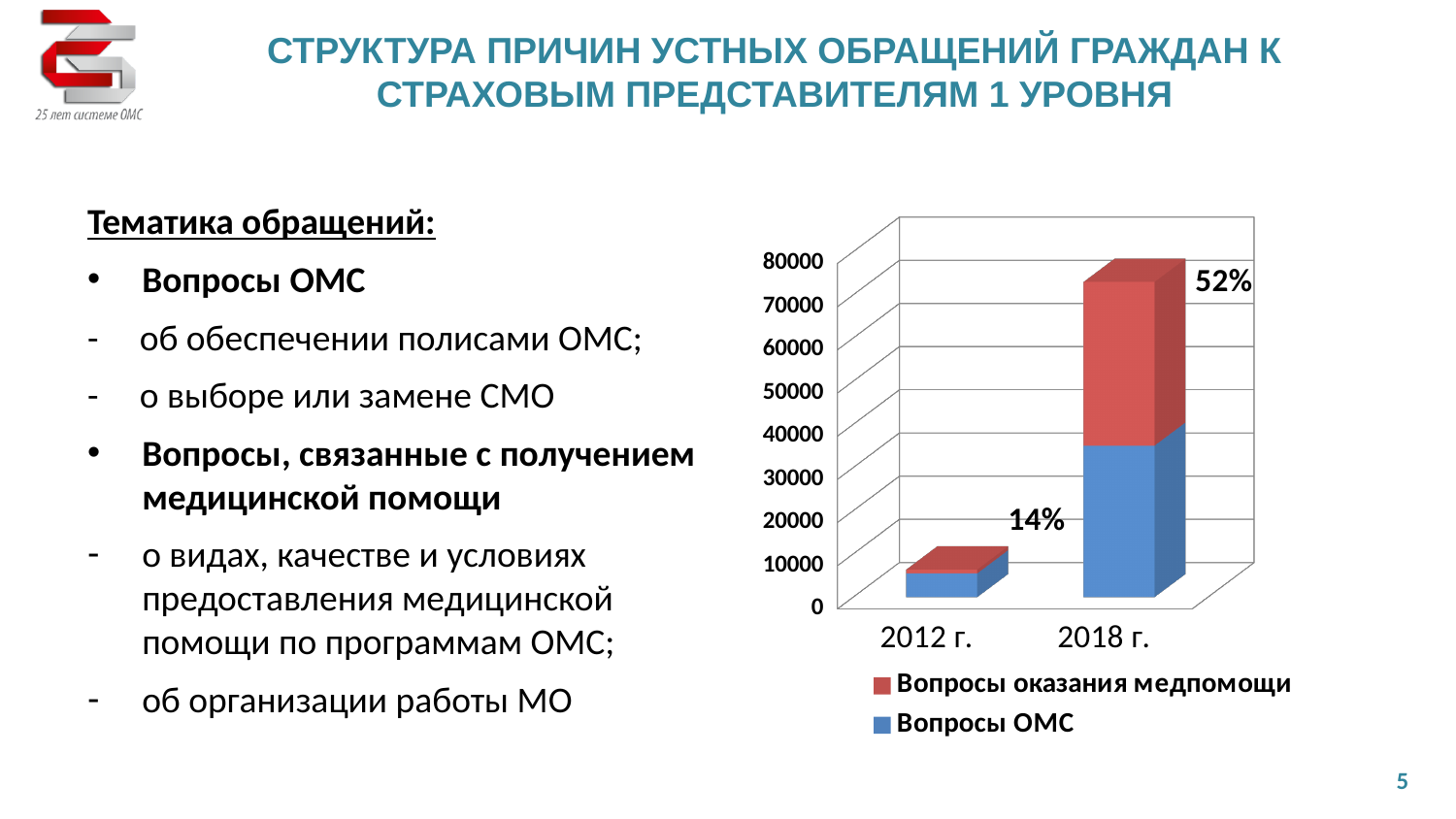
How many series does the chart legend list? 2 Which colour represents the series Вопросы ОМС in the chart? Blue How many categories (years) are shown on the x axis of the chart? 2 Which year has the lower total bar in the chart? 2012 г. Which year has the higher total bar in the chart? 2018 г. What percentage label is shown next to the bar for 2018 г.? 52% What percentage label is shown next to the bar for 2012 г.? 14% What kind of chart is shown on the slide? Stacked bar chart Is the total value of the bar for 2012 г. greater or less than 20000? less Is the value of Вопросы ОМС for 2018 г. greater or less than 20000? greater Is the total value of the bar for 2018 г. greater or less than 50000? greater Do the total values rise or fall from 2012 г. to 2018 г.? Rise